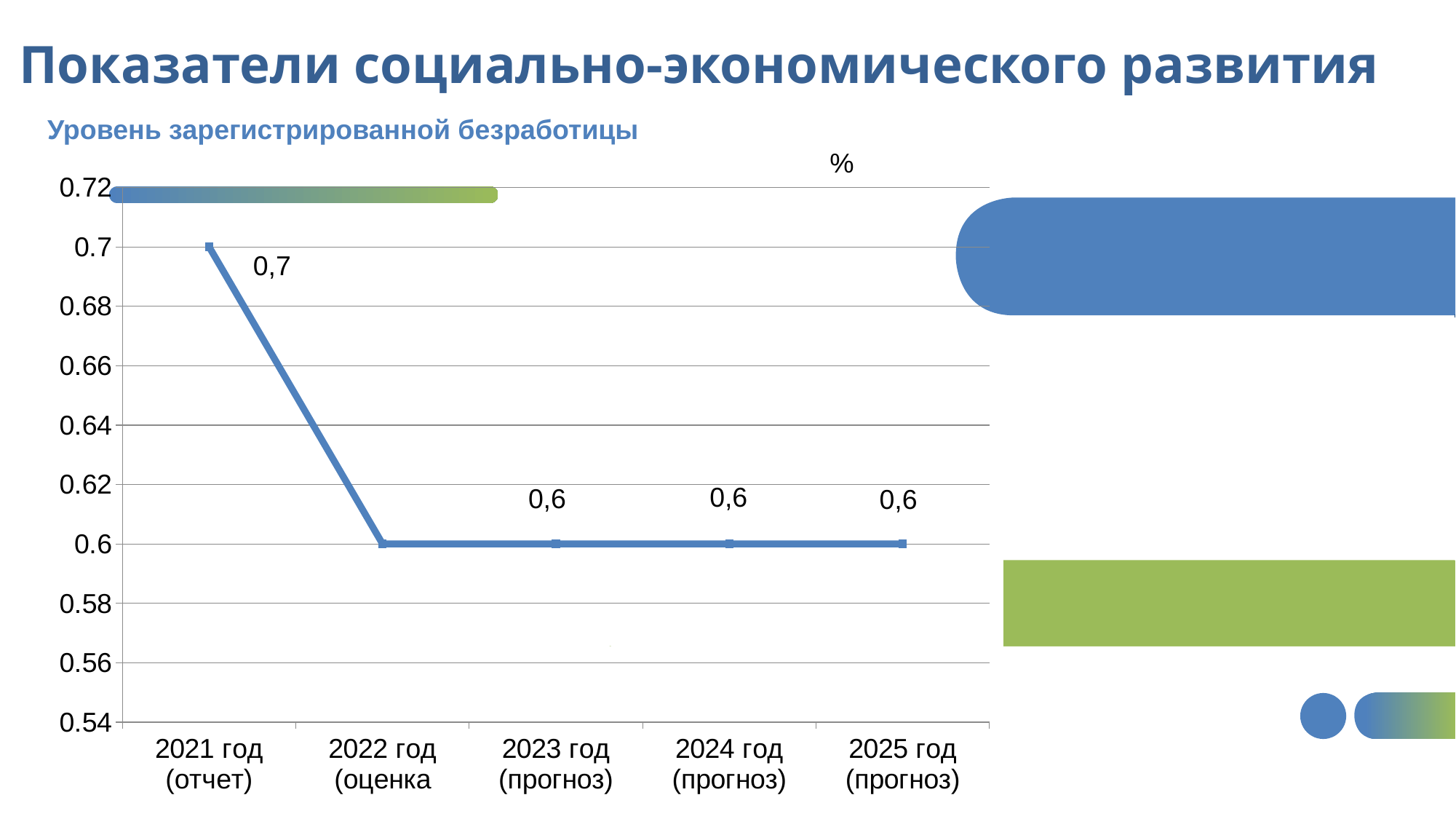
Which is larger: the value for 2021 год (отчет) or the value for 2025 год (прогноз)? 2021 год (отчет) What is the difference between the values for 2021 год (отчет) and 2024 год (прогноз)? 0,1 What is the value shown for 2023 год (прогноз)? 0,6 What unit is indicated above the chart? % What value does the point for 2022 год (оценка) land on according to the vertical axis? 0.6 How does the registered unemployment rate change from 2021 to 2025? It falls from 2021 to 2022, then stays flat What kind of chart is shown on the slide? line chart Which year has the highest registered unemployment rate? 2021 год (отчет) How many years are plotted on the chart? 5 Is the value for 2022 год (оценка) greater or less than 0.64? less What is the value shown for 2025 год (прогноз)? 0,6 What is the registered unemployment rate for 2021 год (отчет)? 0,7